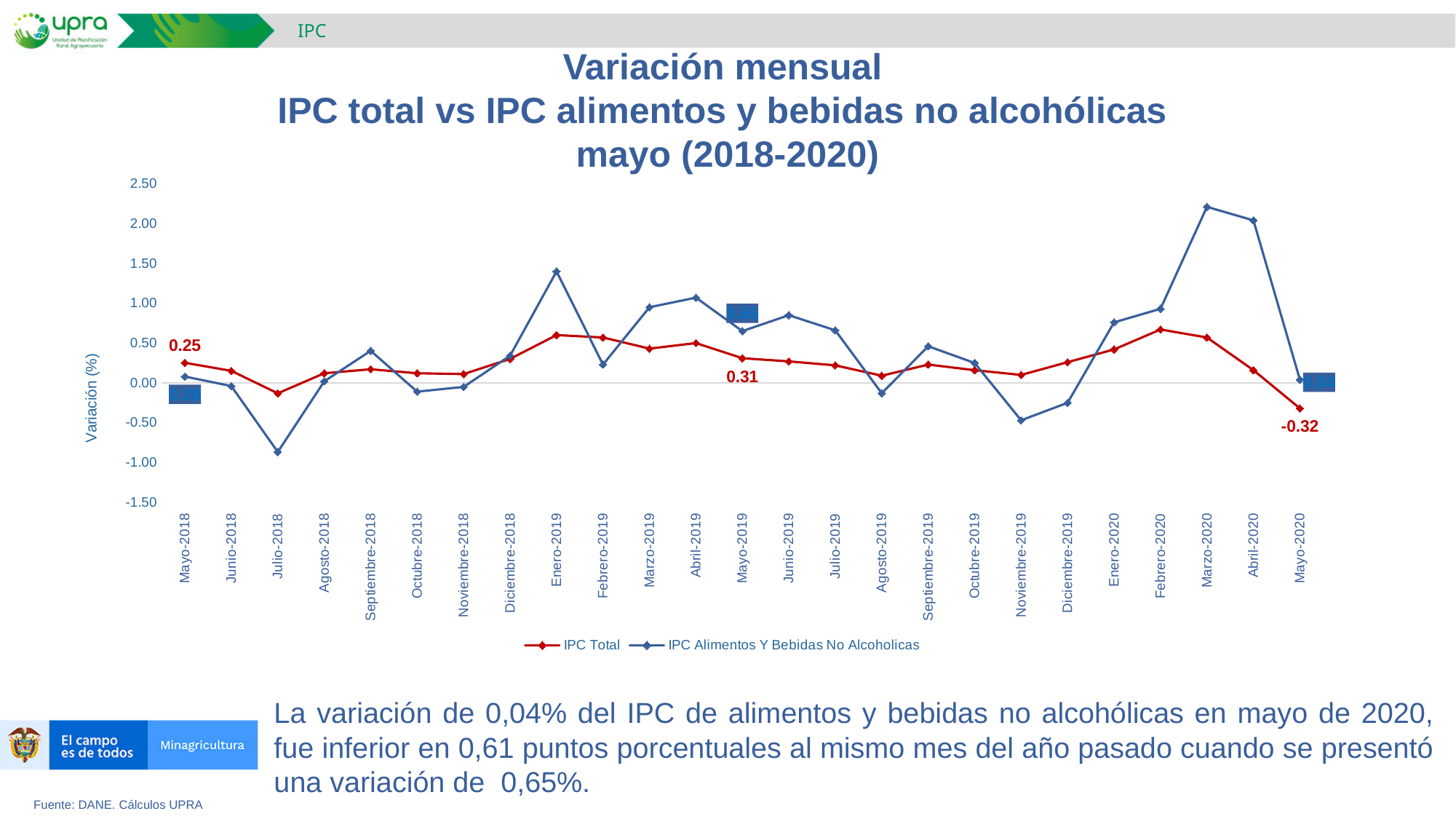
What kind of chart is shown on the slide? Line chart Is the value for IPC Alimentos Y Bebidas No Alcoholicas in Marzo-2020 greater or less than 2.00? greater In Marzo-2020, which series has the larger value, IPC Total or IPC Alimentos Y Bebidas No Alcoholicas? IPC Alimentos Y Bebidas No Alcoholicas How many series does the legend list? 2 What is the value of IPC Total for Mayo-2020? -0.32 What is the value of IPC Total for Mayo-2019? 0.31 Is the value for IPC Alimentos Y Bebidas No Alcoholicas in Julio-2018 greater or less than -0.50? less What is the value of IPC Total for Mayo-2018? 0.25 What is the difference between the IPC Total values for Mayo-2018 and Mayo-2020? 0.57 In which month does the IPC Alimentos Y Bebidas No Alcoholicas series reach its highest value? Marzo-2020 In which month does the IPC Alimentos Y Bebidas No Alcoholicas series reach its lowest value? Julio-2018 In which month does the IPC Total series reach its lowest value? Mayo-2020